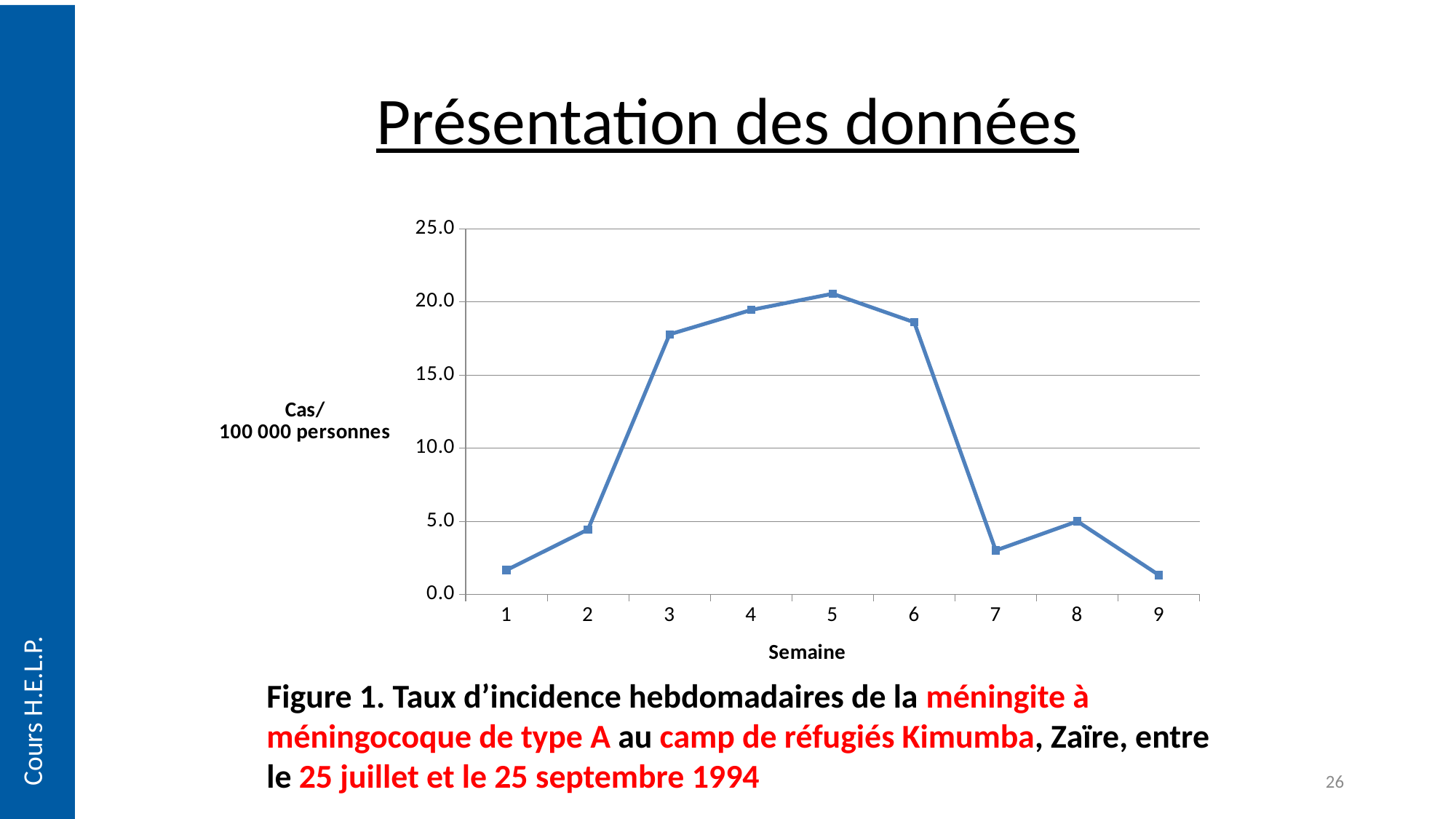
What kind of chart is shown on the slide? line chart Is the value for week 7 greater or less than 5.0? less Which week has the highest incidence rate? 5 Is the value for week 6 greater or less than 20.0? less Is the value for week 1 greater or less than 5.0? less Which is larger, the value for week 3 or the value for week 7? week 3 What is the label of the y axis? Cas/100 000 personnes Do the values rise or fall from week 1 to week 5? rise What is the title of the x axis? Semaine How many weeks are plotted on the x axis? 9